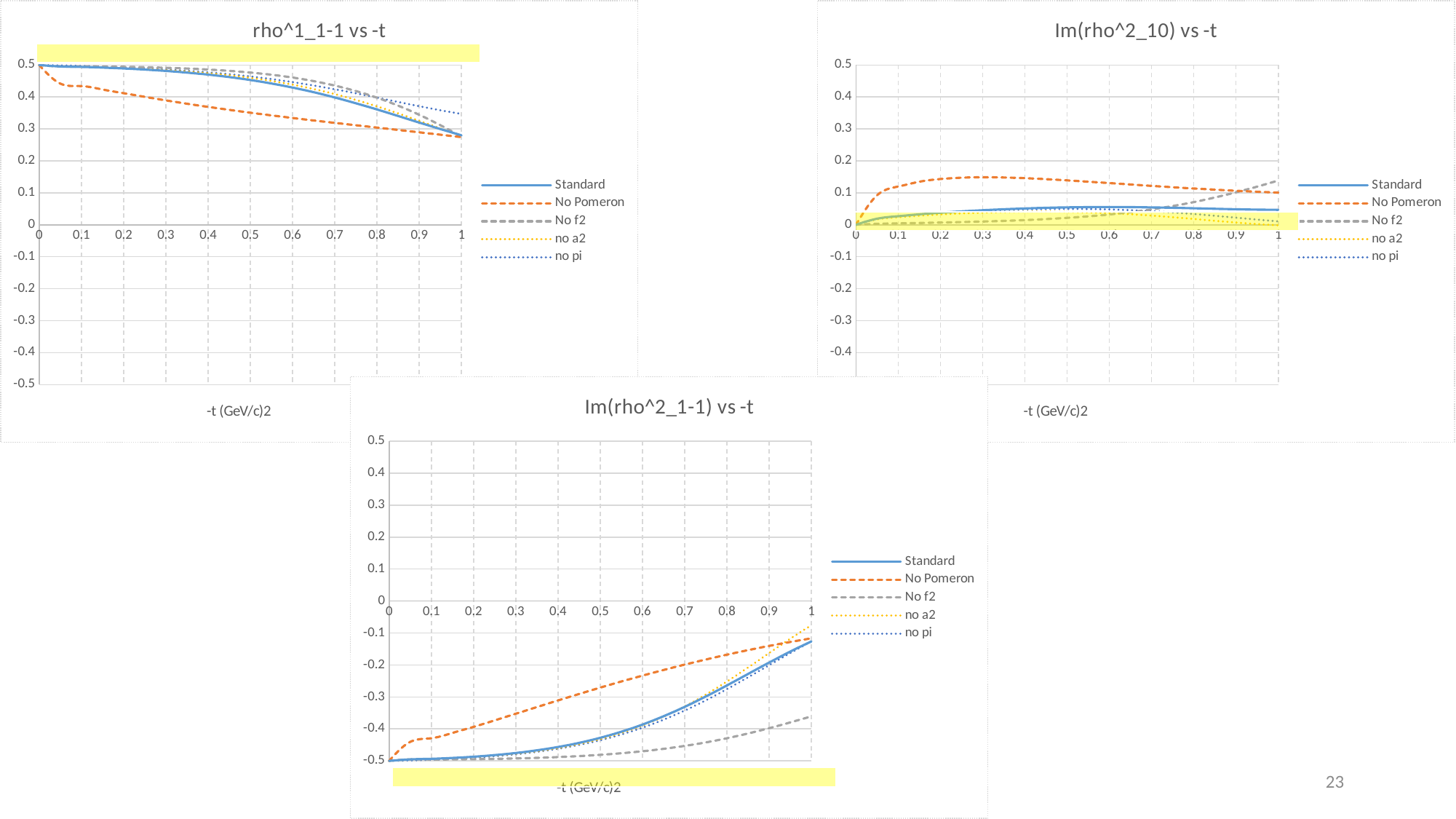
In the chart "Im(rho^2_10) vs -t", which series reaches the highest value? No Pomeron What is the x-axis label of the chart "Im(rho^2_1-1) vs -t"? -t (GeV/c)2 In the chart "Im(rho^2_1-1) vs -t", at -t = 0.5, which is larger: the No Pomeron series or the No f2 series? No Pomeron In the chart "rho^1_1-1 vs -t", is the value of the no pi series at -t = 1 greater or less than 0.3? greater In the chart "Im(rho^2_1-1) vs -t", does the Standard series rise or fall as -t increases from 0 to 1? rise In the chart "Im(rho^2_10) vs -t", how many series does the legend list? 5 In the chart "rho^1_1-1 vs -t", at -t = 0.2, which is larger: the Standard series or the No Pomeron series? Standard In the chart "rho^1_1-1 vs -t", does the Standard series rise or fall as -t increases from 0 to 1? fall How many charts are shown on the slide? 3 What kind of chart is "rho^1_1-1 vs -t"? line chart In the chart "Im(rho^2_10) vs -t", is the value of the No Pomeron series at -t = 0.3 greater or less than 0.1? greater In the chart "Im(rho^2_1-1) vs -t", is the value of the No f2 series at -t = 1 greater or less than -0.3? less